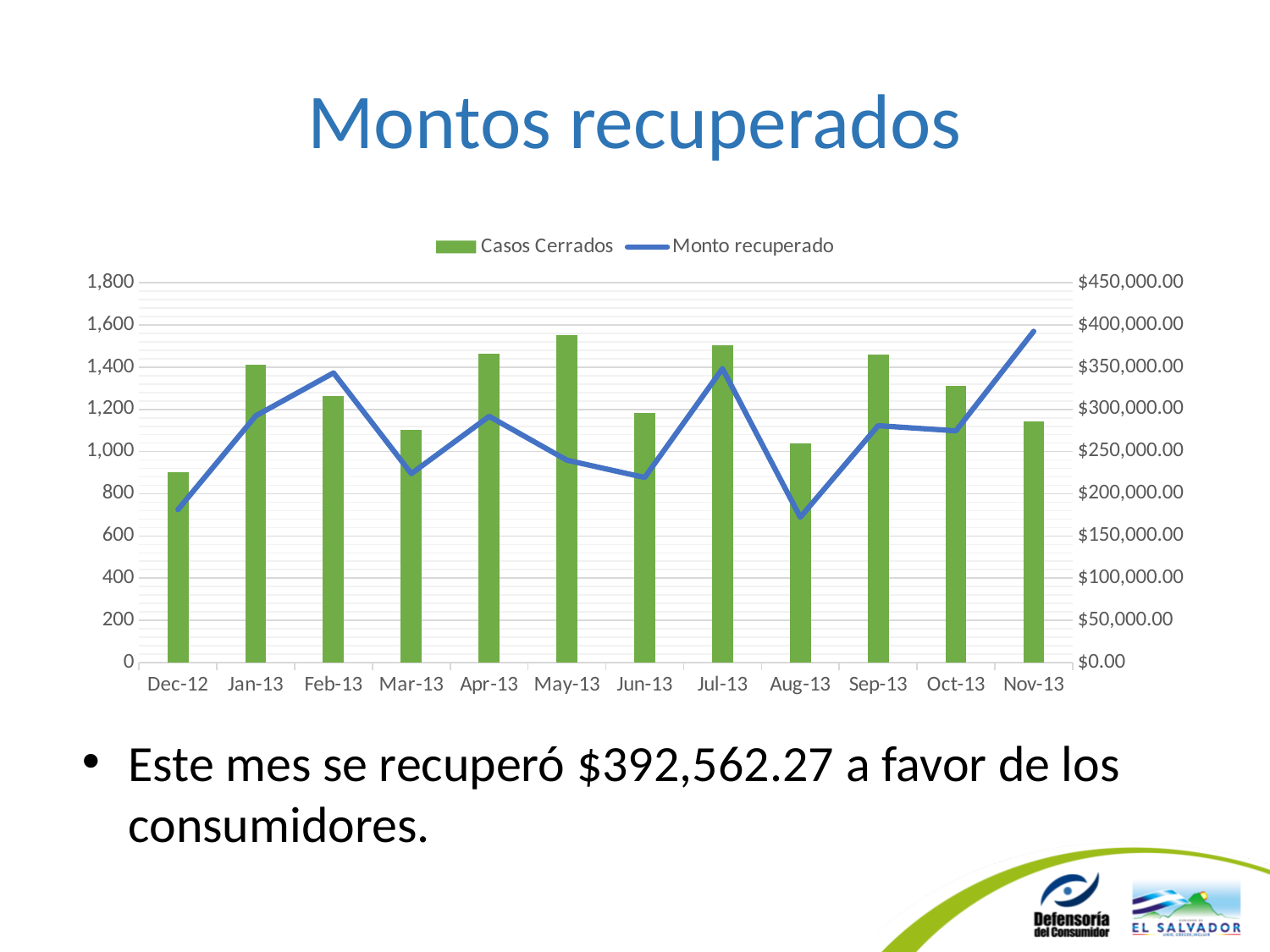
Which month has the lowest number of Casos Cerrados? Dec-12 Which month has more Casos Cerrados, Jan-13 or Mar-13? Jan-13 Does the Monto recuperado rise or fall from Aug-13 to Nov-13? rise Which month has the highest Monto recuperado? Nov-13 Is the Monto recuperado for Nov-13 greater or less than $350,000.00? greater Which month has the highest number of Casos Cerrados? May-13 Is the number of Casos Cerrados in Dec-12 greater or less than 1,000? less How many months are shown on the x axis of the chart? 12 What kind of chart is shown on the slide? Combined bar and line chart How many series does the chart legend list? 2 What is the title of the chart? Montos recuperados Is the Monto recuperado for Aug-13 greater or less than $200,000.00? less